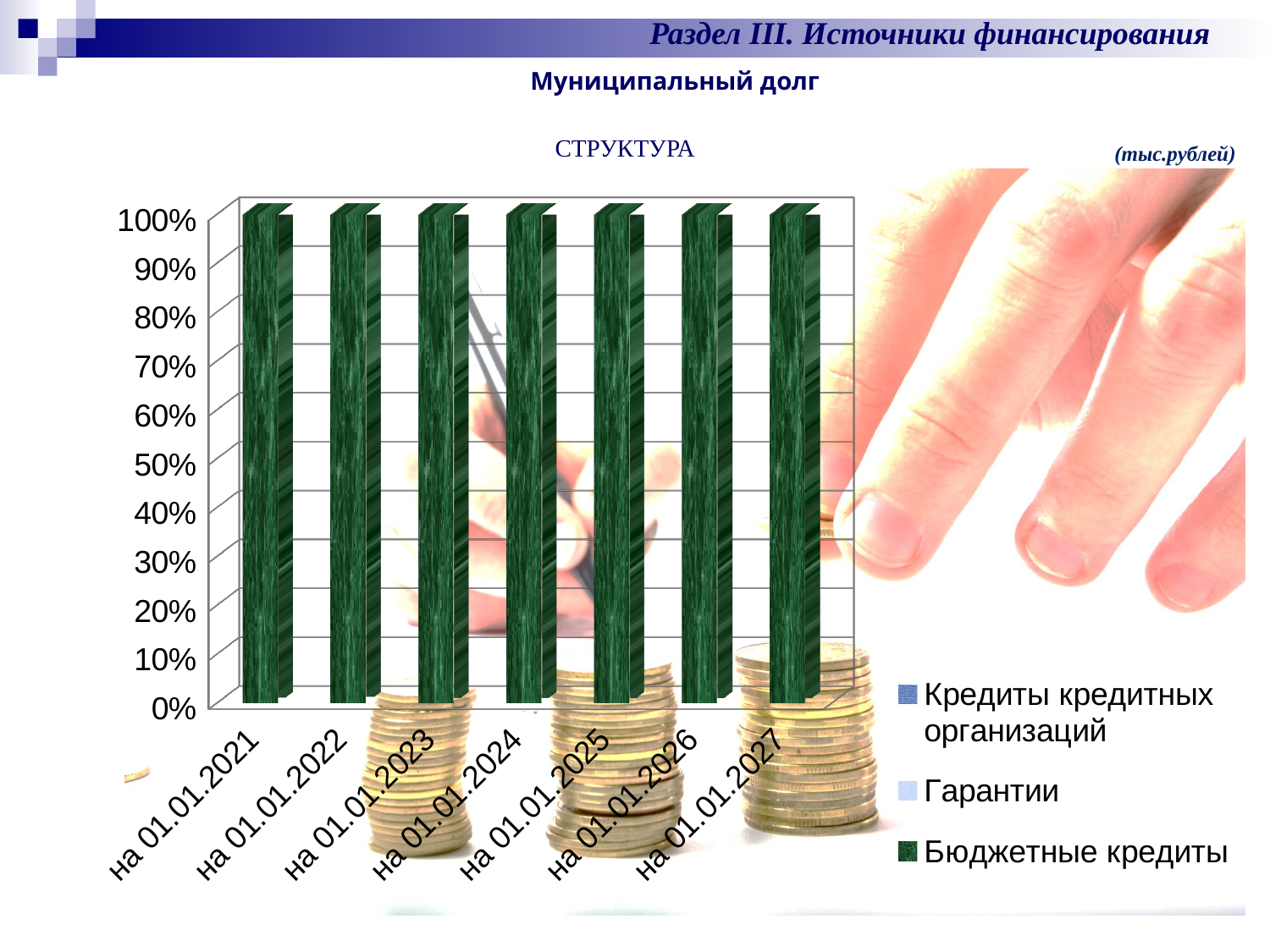
What is the highest tick value shown on the vertical axis of the chart? 100% Is the value for Бюджетные кредиты on на 01.01.2024 greater or less than 50%? greater How many dates (categories) are shown along the x axis of the chart? 7 Which series is shown in green in the chart legend? Бюджетные кредиты How many series does the chart legend list? 3 What share does Бюджетные кредиты make up of the bar for на 01.01.2021? 100% What share does Бюджетные кредиты make up of the bar for на 01.01.2027? 100% What kind of chart is shown on the slide? bar chart Does the share of Бюджетные кредиты rise, fall or stay flat from на 01.01.2021 to на 01.01.2027? stays flat Is the value for Бюджетные кредиты on на 01.01.2022 greater or less than 90%? greater What is the first date shown on the x axis of the chart? на 01.01.2021